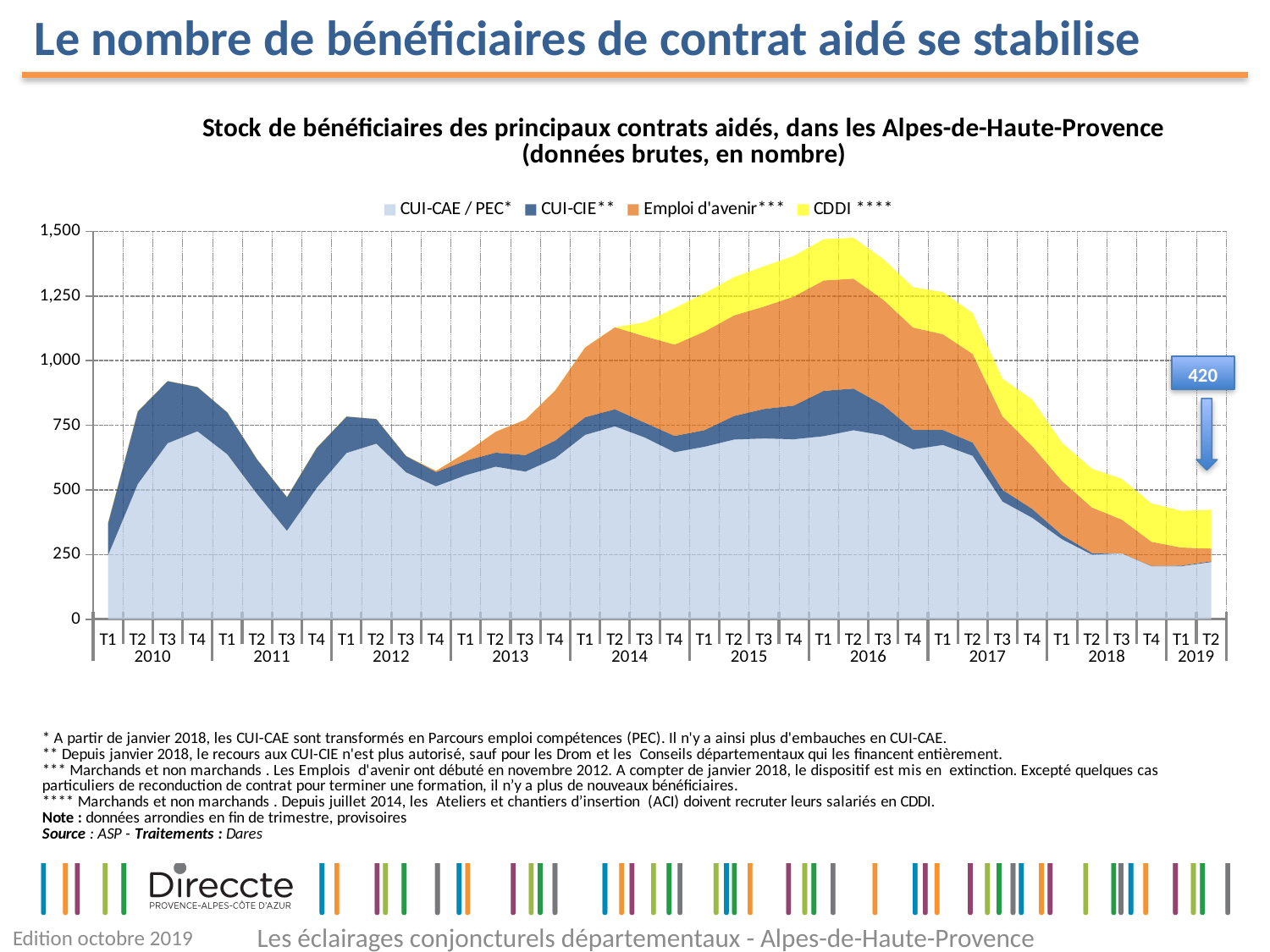
Is the total stock of beneficiaries in T3 2010 greater or less than 750? greater How many years are shown on the x axis? 10 How many series does the legend list? 4 Is the total stock of beneficiaries in T1 2016 greater or less than 1,250? greater Is the total stock of beneficiaries in T2 2019 greater or less than 500? less What total value is shown by the callout label at the end of the series (T2 2019)? 420 Does the total stock of beneficiaries rise or fall between T4 2012 and T1 2016? rise Does the total stock of beneficiaries rise or fall between T1 2016 and T2 2019? fall Which series is at the bottom of the stacked areas? CUI-CAE / PEC* In which year does the CDDI series first appear on the chart? 2014 What kind of chart is shown on the slide? Stacked area chart